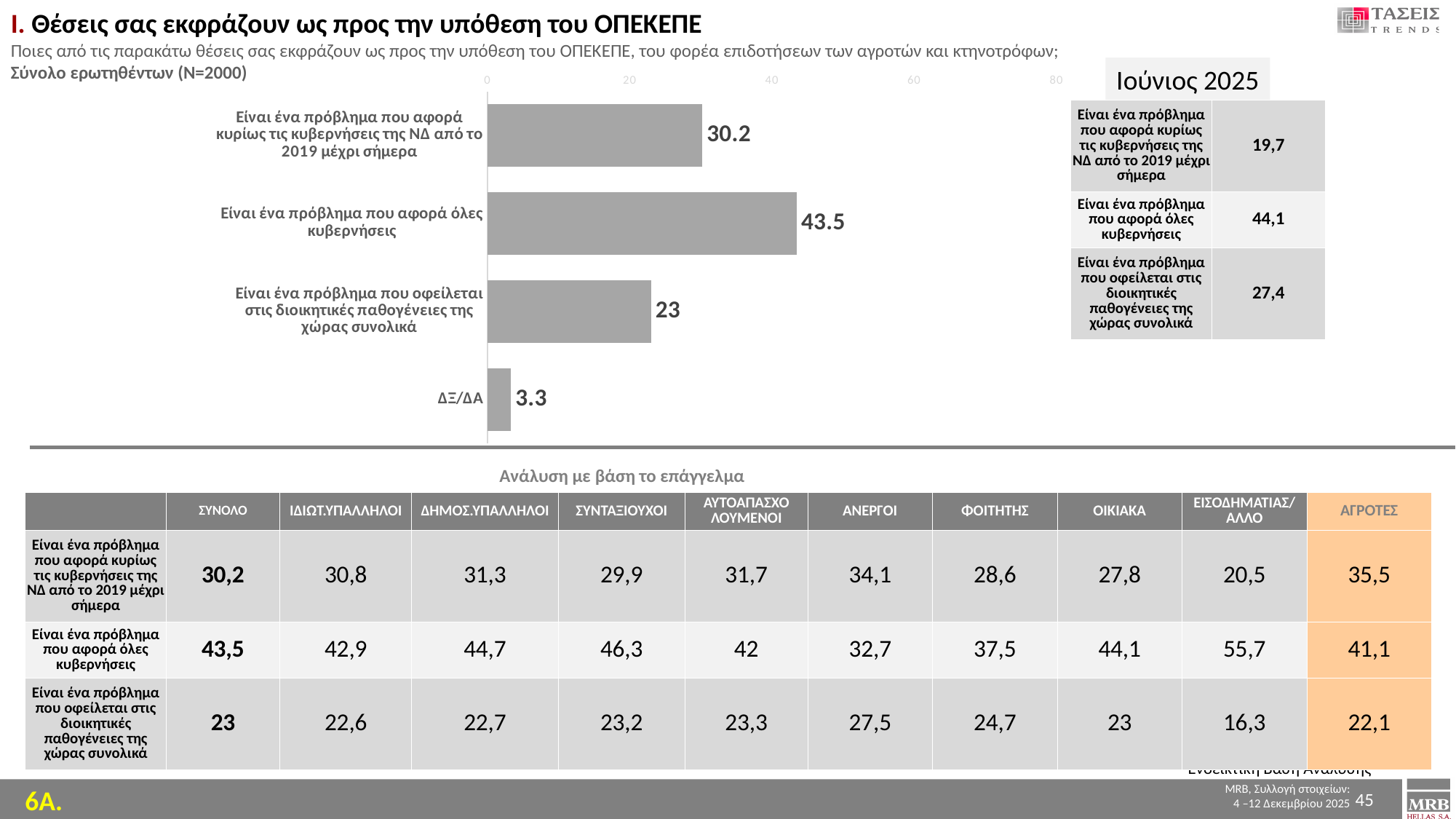
What is the difference between the value for "Είναι ένα πρόβλημα που αφορά όλες κυβερνήσεις" and the value for "Είναι ένα πρόβλημα που αφορά κυρίως τις κυβερνήσεις της ΝΔ από το 2019 μέχρι σήμερα"? 13.3 What kind of chart is shown on the slide? bar chart What value is shown for the bar "ΔΞ/ΔΑ"? 3.3 What value is shown for the bar "Είναι ένα πρόβλημα που οφείλεται στις διοικητικές παθογένειες της χώρας συνολικά"? 23 What value is shown for the bar "Είναι ένα πρόβλημα που αφορά κυρίως τις κυβερνήσεις της ΝΔ από το 2019 μέχρι σήμερα"? 30.2 Which is larger: the value for "Είναι ένα πρόβλημα που οφείλεται στις διοικητικές παθογένειες της χώρας συνολικά" or the value for "ΔΞ/ΔΑ"? Είναι ένα πρόβλημα που οφείλεται στις διοικητικές παθογένειες της χώρας συνολικά Is the value for "Είναι ένα πρόβλημα που αφορά όλες κυβερνήσεις" greater or less than 40? greater What is the highest tick value shown on the chart's value axis? 80 How many categories (bars) are shown in the bar chart? 4 Which category has the lowest value in the bar chart? ΔΞ/ΔΑ Which category has the highest value in the bar chart? Είναι ένα πρόβλημα που αφορά όλες κυβερνήσεις What value is shown for the bar "Είναι ένα πρόβλημα που αφορά όλες κυβερνήσεις"? 43.5